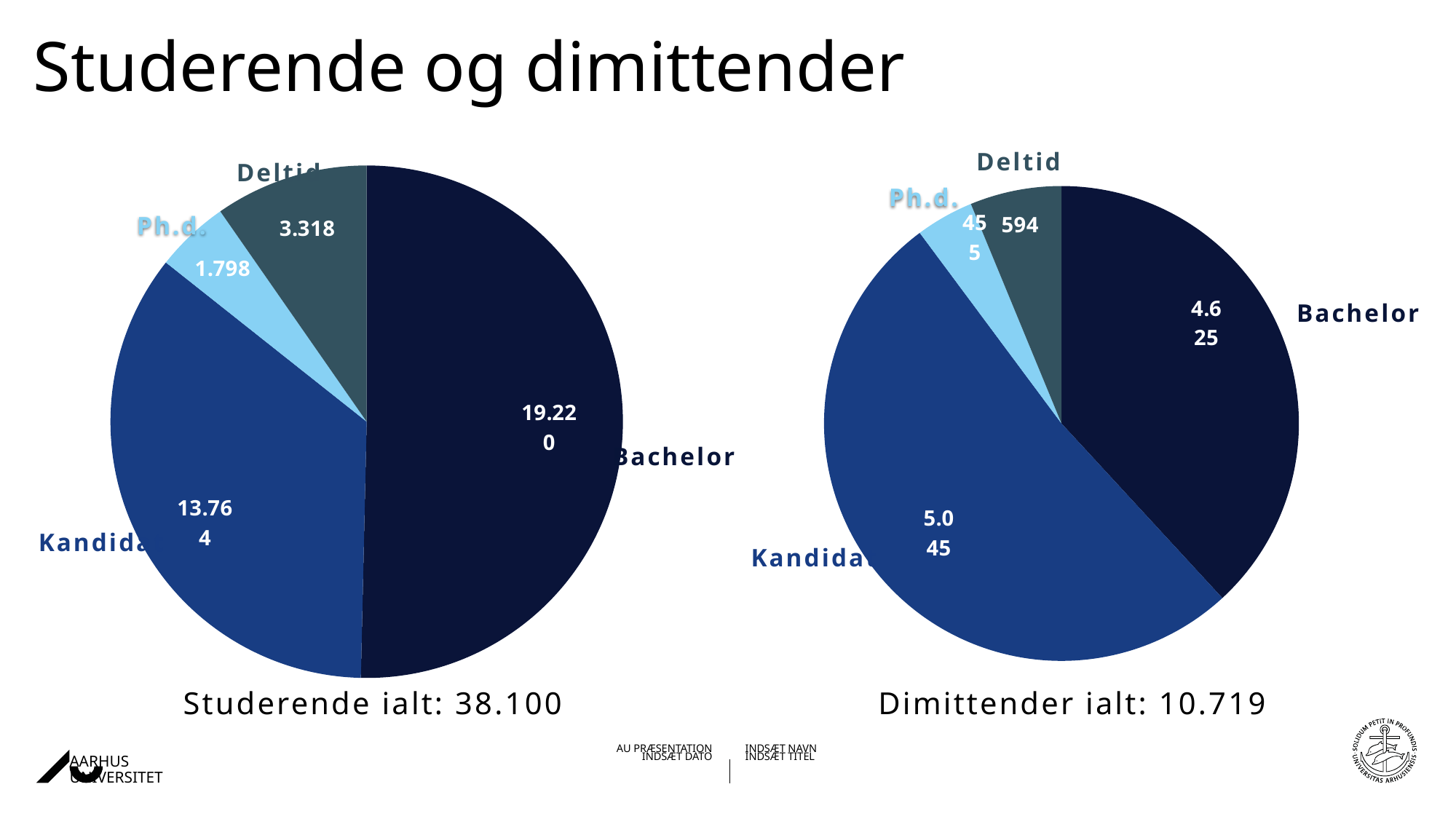
What type of chart is used for Dimittender on the right? Pie chart In the left pie chart (Studerende), what is the value for Deltid? 3.318 In the left pie chart (Studerende), which category has the largest slice? Bachelor How many categories does the left pie chart (Studerende) show? 4 In the left pie chart (Studerende), what is the value for Ph.d.? 1.798 In the right pie chart (Dimittender), what is the value for Kandidat? 5.045 In the right pie chart (Dimittender), what is the value for Deltid? 594 In the left pie chart (Studerende), what is the difference between Deltid and Ph.d.? 1.520 In the right pie chart (Dimittender), which is larger, Bachelor or Kandidat? Kandidat What total is stated below the left pie chart (Studerende ialt)? 38.100 What total is stated below the right pie chart (Dimittender ialt)? 10.719 In the right pie chart (Dimittender), which category has the smallest slice? Ph.d.